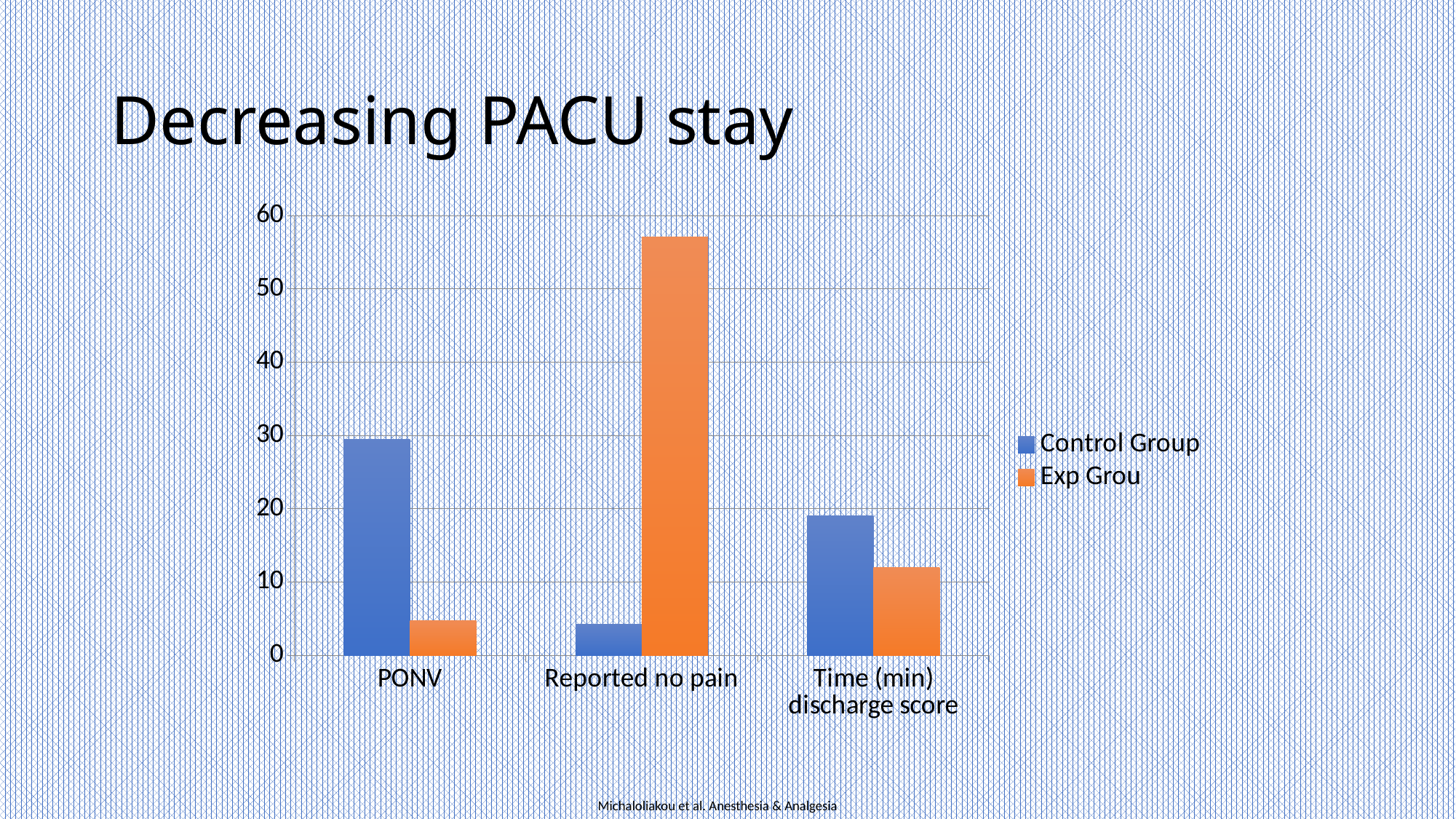
Is the Exp Grou value for Reported no pain greater or less than 50? greater Is the Control Group value for Time (min) discharge score greater or less than 20? less Which category has the lowest Exp Grou bar? PONV How many categories are shown on the x axis of the chart? 3 Which category has the highest Exp Grou bar? Reported no pain How many series does the chart's legend list? 2 Which category has the lowest Control Group bar? Reported no pain For PONV, which is larger: the Control Group value or the Exp Grou value? Control Group What kind of chart is shown on the slide? bar chart Which category has the highest Control Group bar? PONV What is the title of the slide containing the chart? Decreasing PACU stay For Reported no pain, which is larger: the Control Group value or the Exp Grou value? Exp Grou